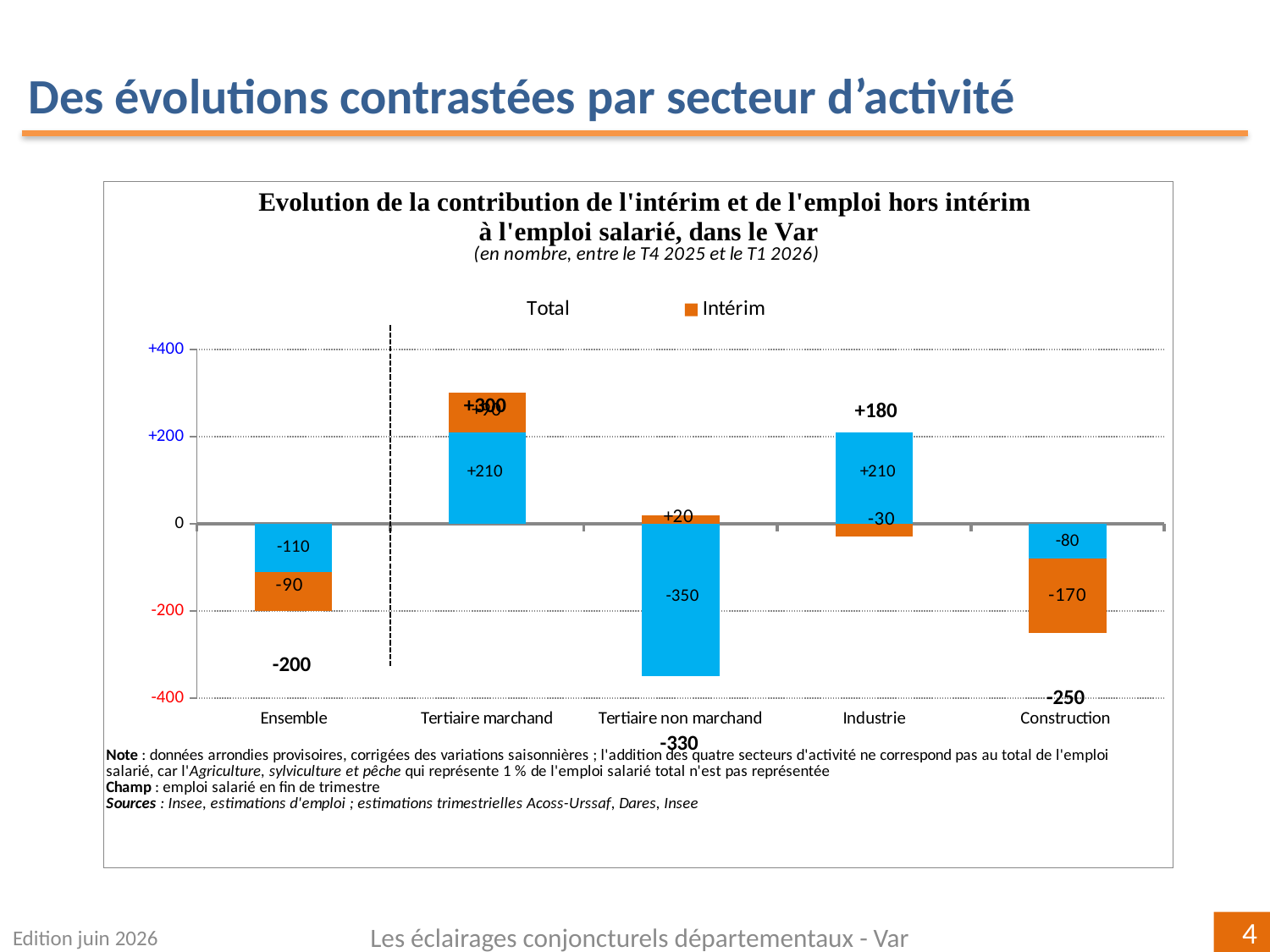
What is the difference between the total for Tertiaire marchand (+300) and the total for Industrie (+180)? 120 What kind of chart is shown on the slide? Bar chart What is the total value shown for Tertiaire non marchand? -330 How many entries does the chart legend list? 2 What is the total value shown for Tertiaire marchand? +300 Which sector has the lowest total value? Tertiaire non marchand Which is larger, the Intérim value for Ensemble or the Intérim value for Industrie? Industrie What is the Intérim value for Construction? -170 Which sector has the highest total value? Tertiaire marchand How many sectors (categories) are shown on the x axis of the chart? 5 What is the blue (non-Intérim) value for Industrie? +210 What is the total value shown for Ensemble? -200